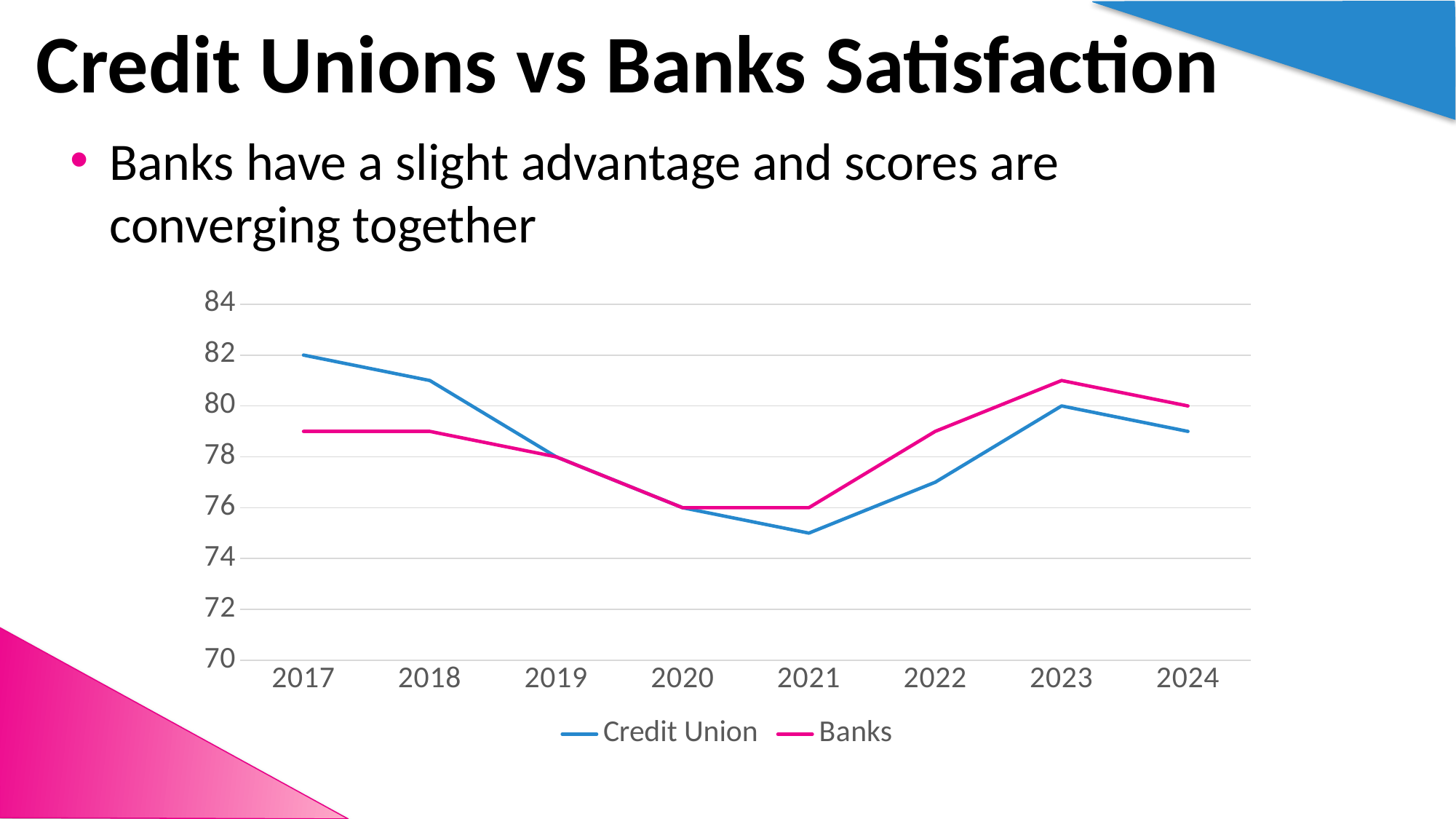
What kind of chart is shown on the slide? Line chart Which series has the larger value in 2023, Credit Union or Banks? Banks In which year is the Banks value highest? 2023 In which year is the Credit Union value highest? 2017 How many years are plotted along the x axis? 8 Is the Credit Union value in 2021 greater or less than 76? less In which year is the Credit Union value lowest? 2021 How many series does the legend list? 2 What is the Credit Union value in 2020? 76 Does the Credit Union line rise or fall from 2017 to 2021? Fall What is the Banks value in 2024? 80 What is the Credit Union value in 2017? 82